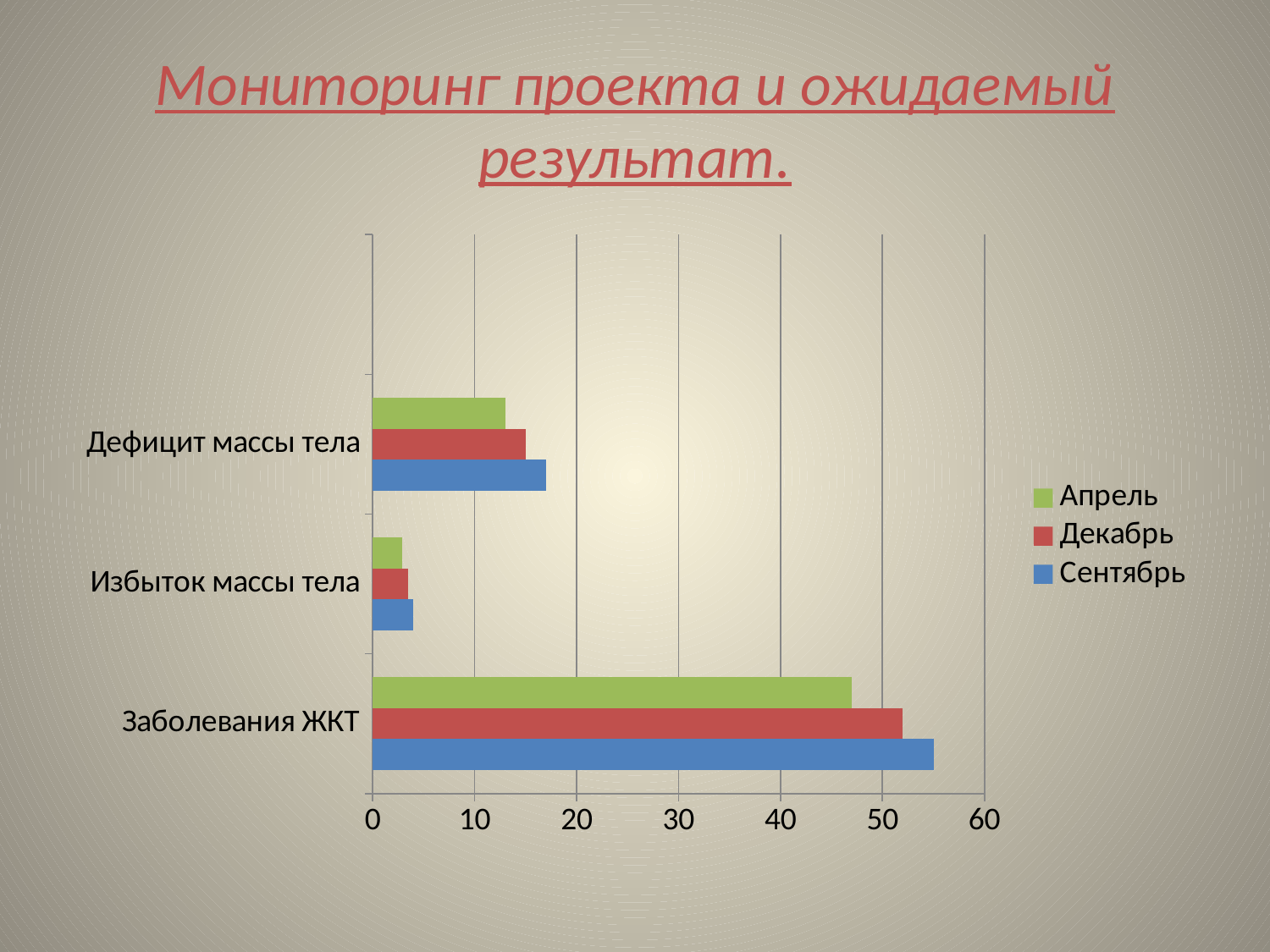
Is the Сентябрь value for Дефицит массы тела greater or less than 20? less Is the Апрель value for Заболевания ЖКТ greater or less than 50? less What kind of chart is shown on the slide? bar chart Is the Сентябрь value for Заболевания ЖКТ greater or less than 50? greater Which category has the highest values across all series? Заболевания ЖКТ For Дефицит массы тела, which series has the larger value: Декабрь or Апрель? Декабрь For Заболевания ЖКТ, which series has the larger value: Сентябрь or Апрель? Сентябрь How many series does the legend list? 3 Which series is shown in green in the legend? Апрель Which category has the lowest values across all series? Избыток массы тела How many categories are shown on the chart? 3